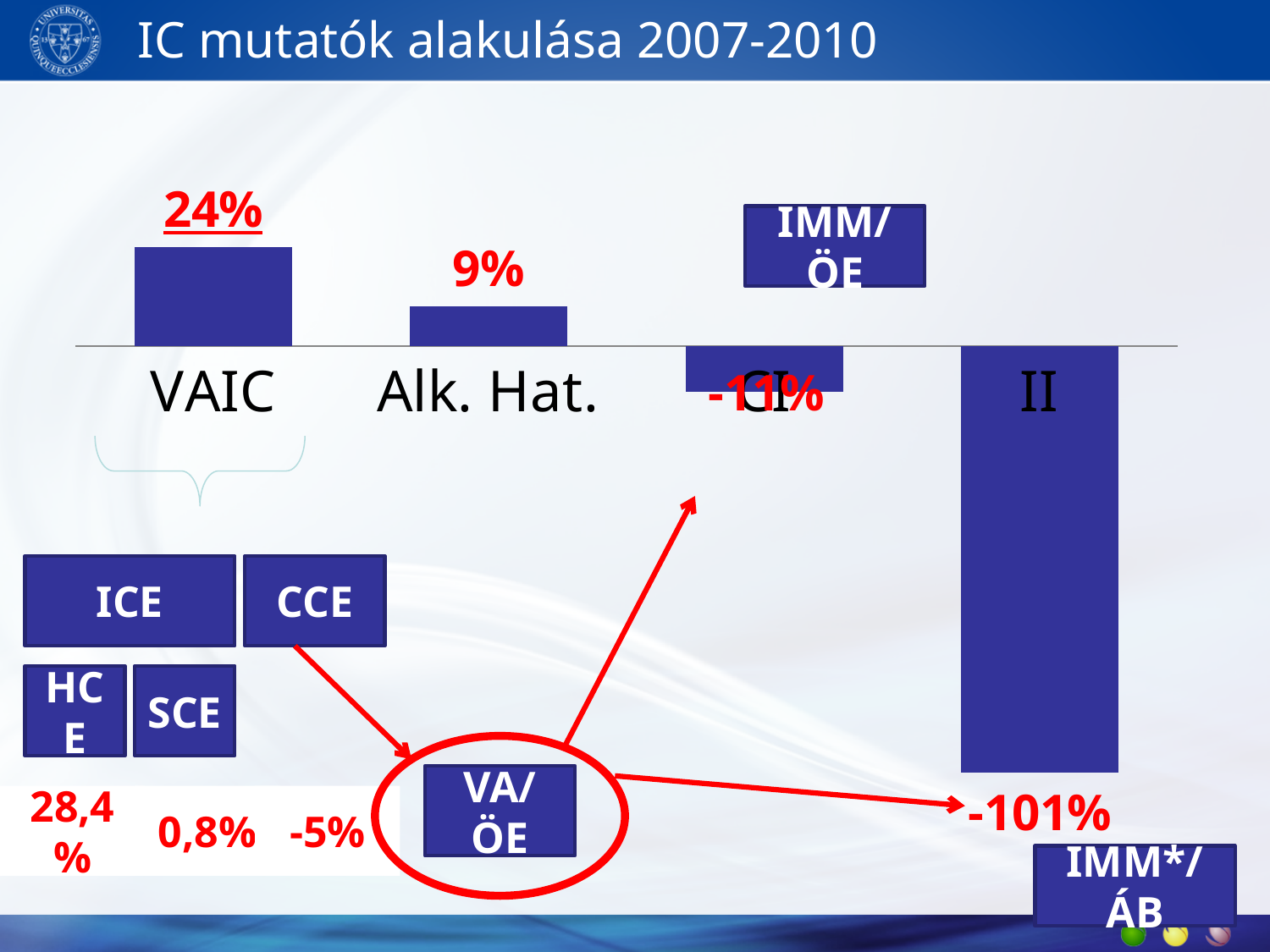
What is the value shown for VAIC? 24% Do the values rise or fall from left to right across the categories? Fall What kind of chart is shown on the slide? Bar chart What is the difference between the values for VAIC and Alk. Hat.? 15 percentage points What is the value shown for CI? -11% Which category has the highest value? VAIC Which is larger, the value for Alk. Hat. or the value for CI? Alk. Hat. What is the title of the slide? IC mutatók alakulása 2007-2010 Which category has the lowest value? II What is the value shown for II? -101% How many categories are plotted in the chart? 4 What is the value shown for Alk. Hat.? 9%